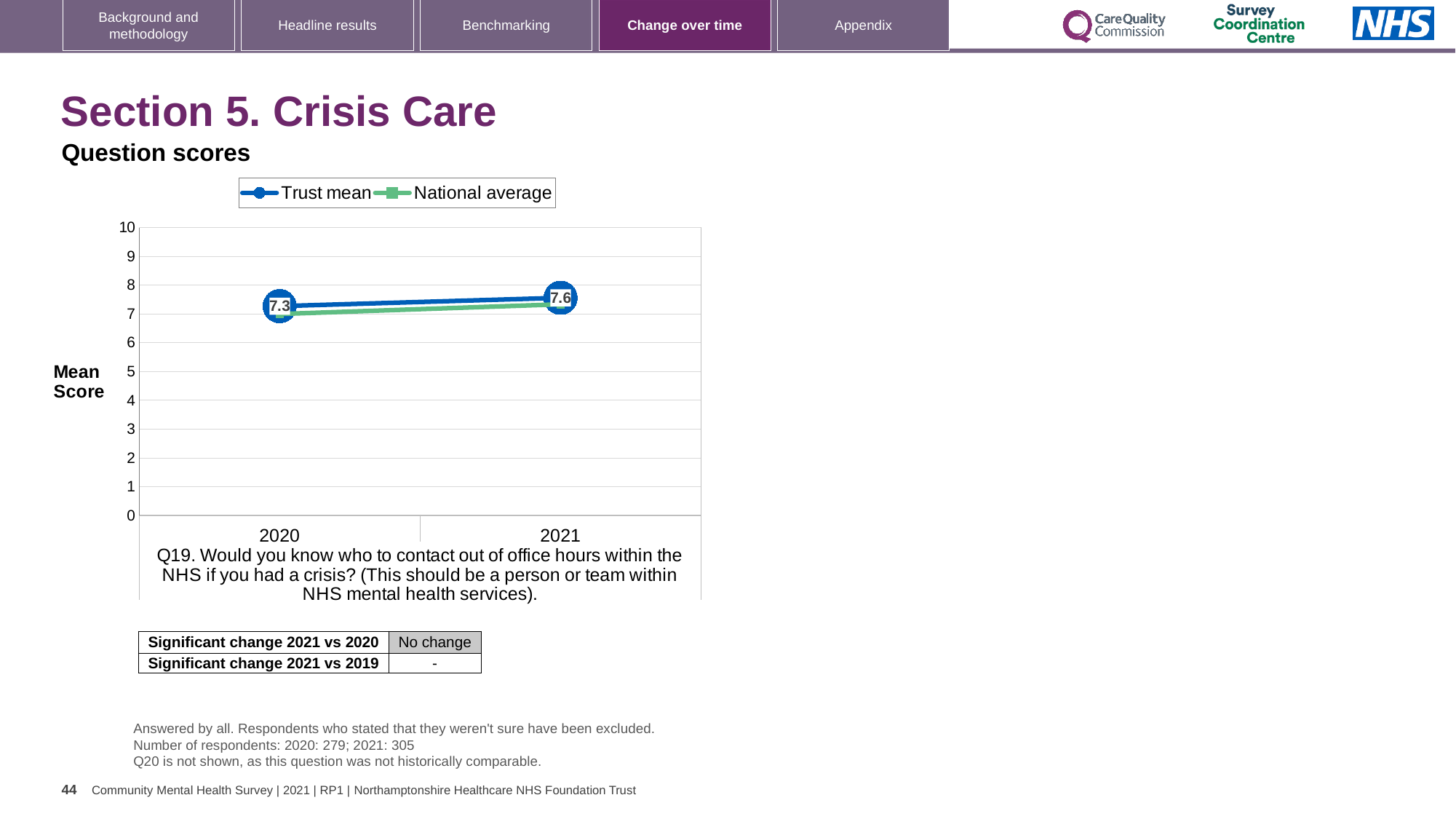
Is the National average value for 2020 greater or less than 8? less How many series does the legend list? 2 By how much did the Trust mean score change from 2020 to 2021? 0.3 Is the National average value for 2021 greater or less than 6? greater In which year is the Trust mean score higher? 2021 Does the Trust mean score rise or fall from 2020 to 2021? rise What is the label on the y axis of the chart? Mean Score What is the Trust mean score for 2021? 7.6 What is the Trust mean score for 2020? 7.3 What kind of chart is shown on the slide? line chart How many years are plotted on the x axis? 2 In 2020, which is higher: the Trust mean or the National average? Trust mean